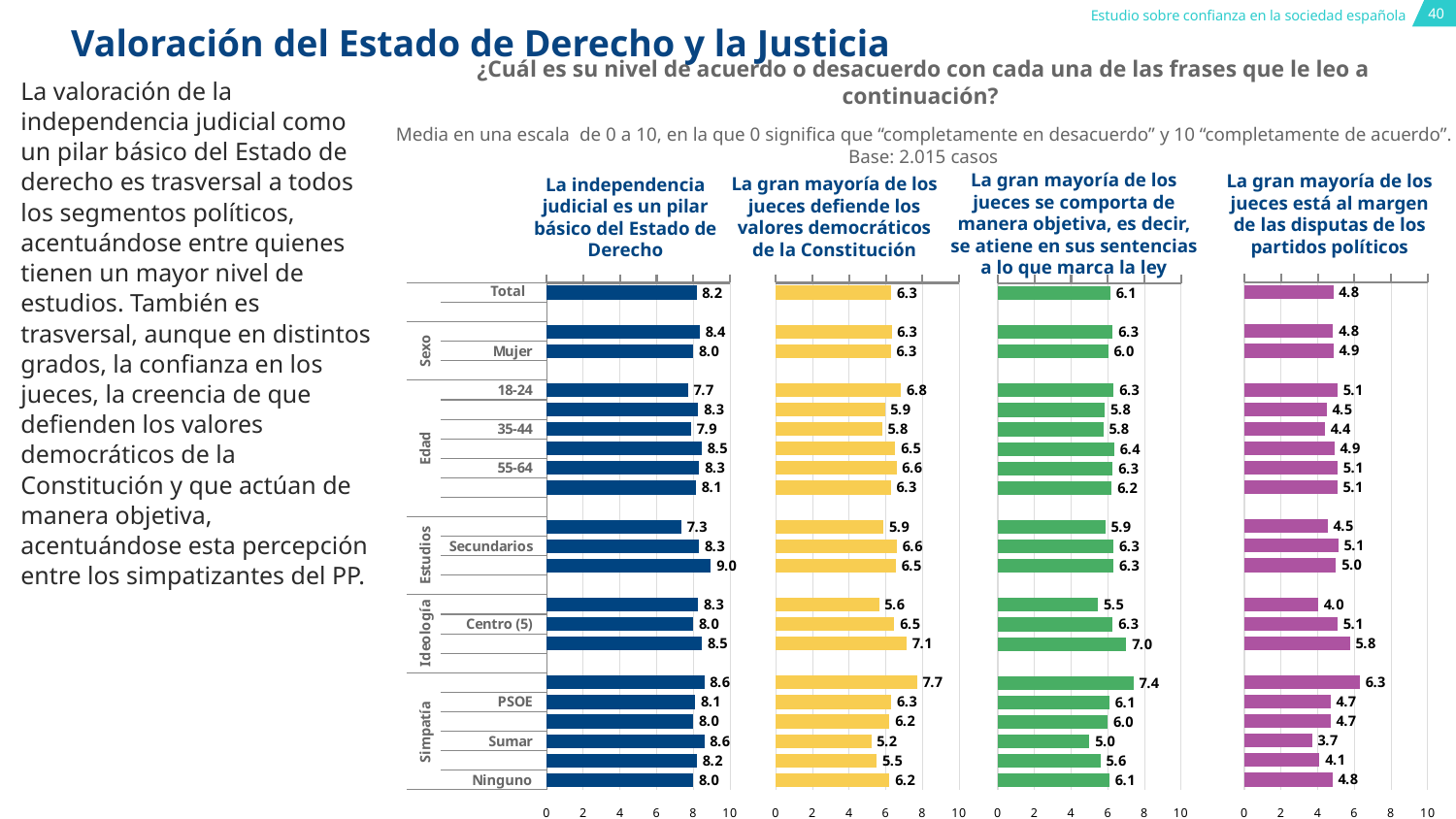
In the chart titled "La gran mayoría de los jueces defiende los valores democráticos de la Constitución", which is larger, the value for 18-24 or the value for 35-44? 18-24 In the chart titled "La gran mayoría de los jueces está al margen de las disputas de los partidos políticos", what is the difference between the values for Total and Sumar? 1.1 In the chart titled "La gran mayoría de los jueces está al margen de las disputas de los partidos políticos", what is the value for Sumar? 3.7 In the chart titled "La independencia judicial es un pilar básico del Estado de Derecho", which is larger, the value for Sumar or the value for Ninguno? Sumar In the chart titled "La independencia judicial es un pilar básico del Estado de Derecho", what is the value for Total? 8.2 What kind of chart is used on this slide? Bar chart In the chart titled "La gran mayoría de los jueces se comporta de manera objetiva, es decir, se atiene en sus sentencias a lo que marca la ley", what is the difference between the values for Total and Sumar? 1.1 In the chart titled "La gran mayoría de los jueces se comporta de manera objetiva, es decir, se atiene en sus sentencias a lo que marca la ley", what is the value for Centro (5)? 6.3 In the chart titled "La independencia judicial es un pilar básico del Estado de Derecho", what is the value for PSOE? 8.1 In the chart titled "La gran mayoría de los jueces defiende los valores democráticos de la Constitución", what is the value for 18-24? 6.8 How many charts are shown on the slide? 4 In the chart titled "La gran mayoría de los jueces está al margen de las disputas de los partidos políticos", is the value for Sumar greater or less than 4? less